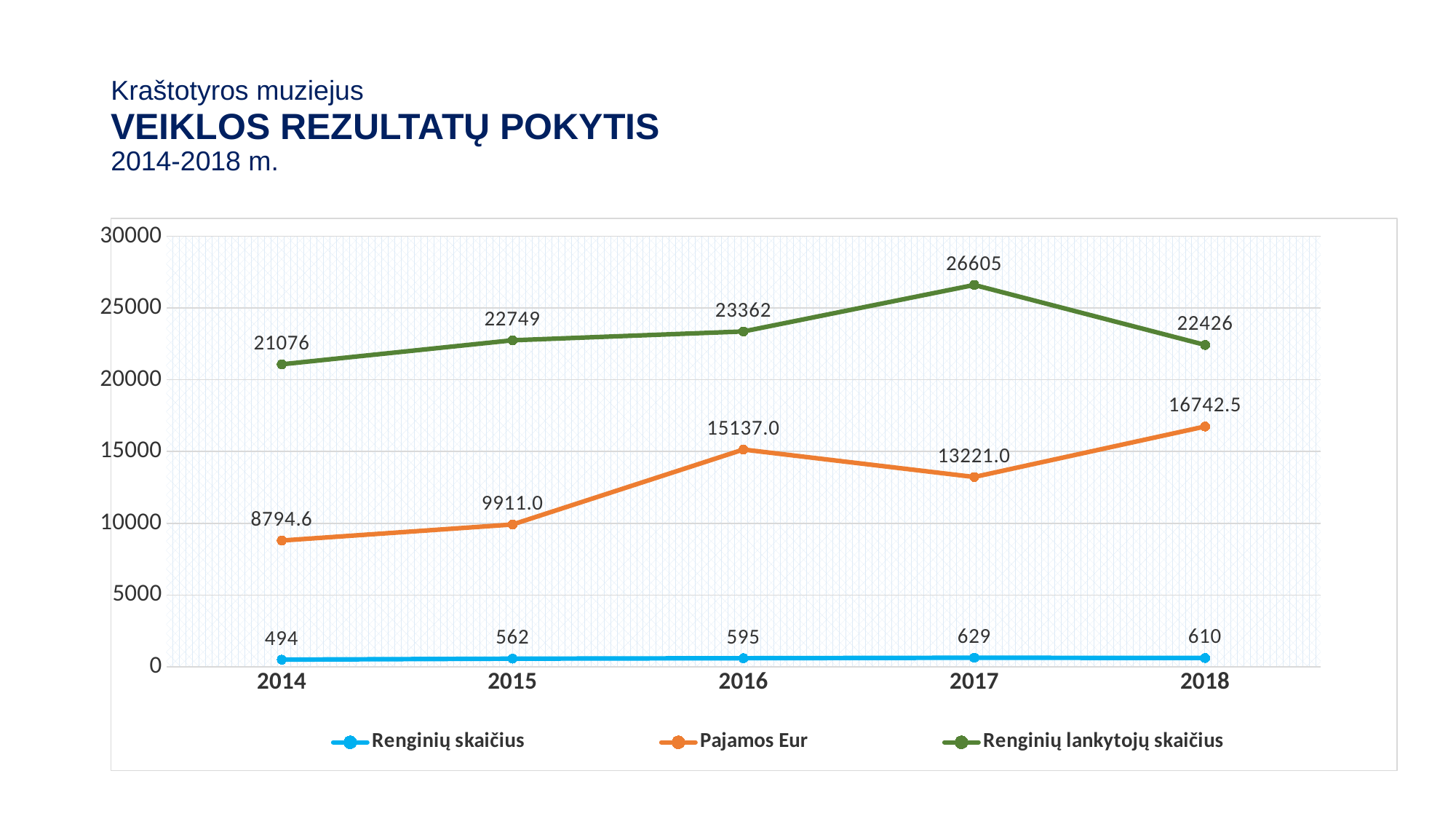
What type of chart is shown on the slide? line chart What is the difference between Renginių lankytojų skaičius in 2017 and 2018? 4179 What is the value of Renginių skaičius in 2017? 629 Which is larger: Pajamos Eur in 2016 or in 2017? 2016 How many series does the legend list? 3 What is the value of Renginių lankytojų skaičius in 2014? 21076 In which year is Pajamos Eur lowest? 2014 Does Renginių skaičius rise or fall from 2014 to 2017? rise Which series is shown in orange in the legend? Pajamos Eur In which year is Renginių lankytojų skaičius highest? 2017 What is the value of Pajamos Eur in 2016? 15137.0 How many years are plotted on the x axis? 5